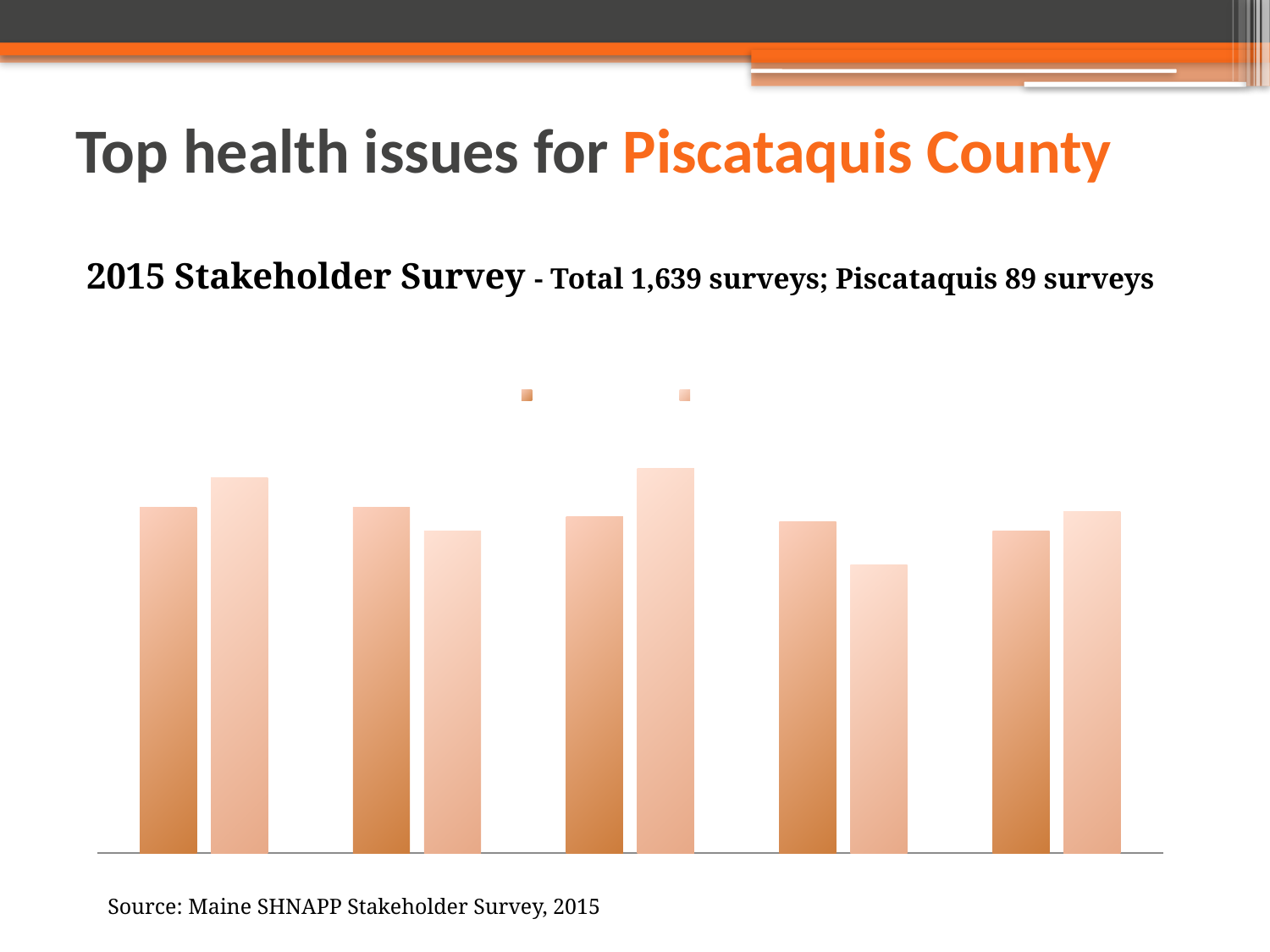
What colours are used for the two series in the chart? dark orange and light orange Does the chart display data labels on its bars? No What kind of chart is shown on the slide? bar chart How many series does the chart's legend list? 2 In the rightmost group of bars, is the darker orange bar or the lighter orange bar taller? the lighter orange bar Which group of bars contains the tallest bar on the chart? the middle (third) group In the leftmost group of bars, is the darker orange bar or the lighter orange bar taller? the lighter orange bar How many bars are plotted in total on the chart? 10 In the middle group of bars, is the darker orange bar or the lighter orange bar taller? the lighter orange bar How many groups of bars does the chart show? 5